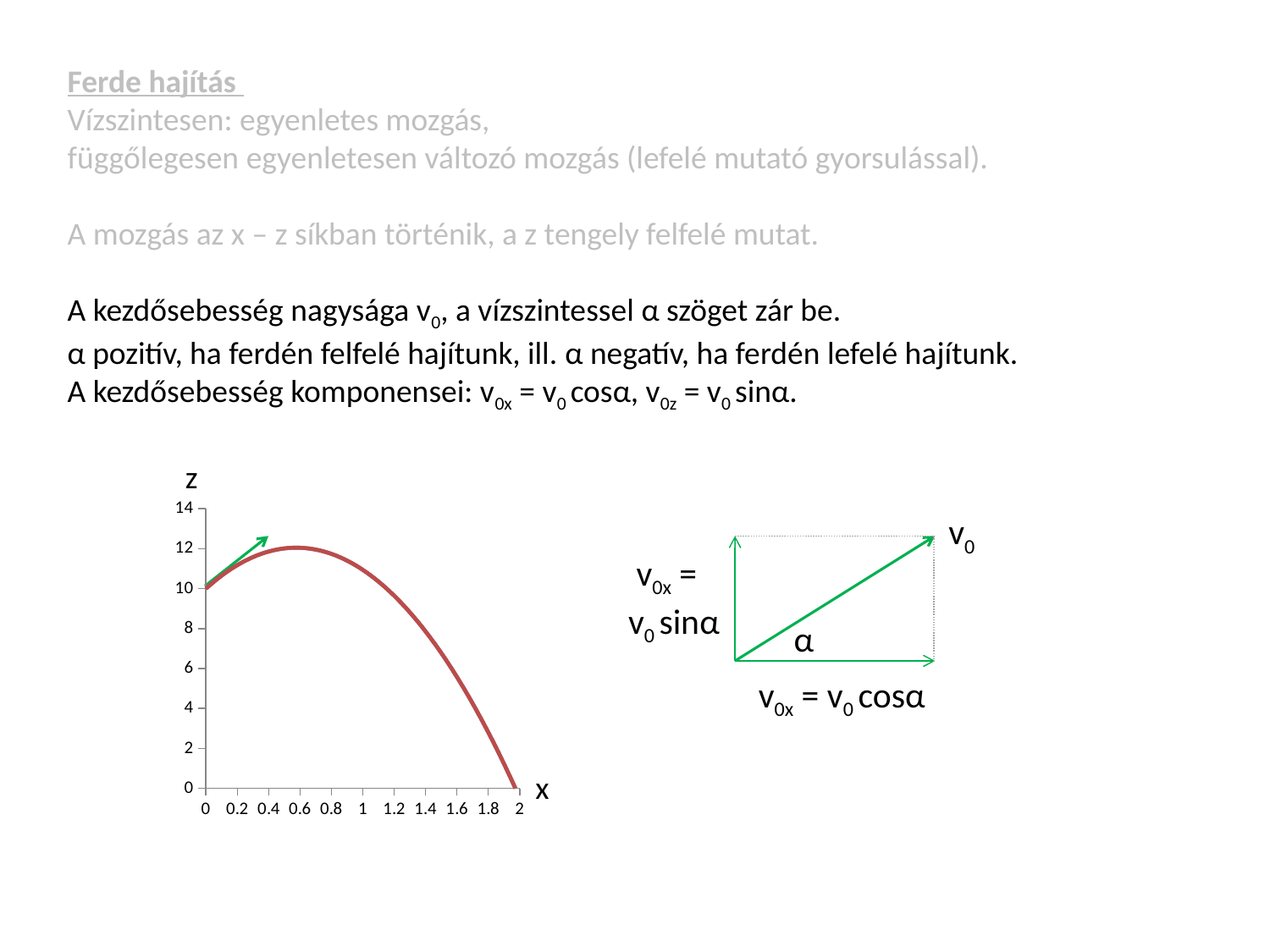
What kind of chart is shown on the slide? line chart What is the highest value shown on the vertical (z) axis? 14 Does the curve rise or fall as x increases from 1 to 2? fall Is the value of z at x = 1 greater or less than 10? greater Is the value of z at x = 1.8 greater or less than 6? less What is the label of the horizontal axis of the chart? x What is the label of the vertical axis of the chart? z Is the value of z at x = 1.6 greater or less than 8? less What is the value of z where the curve starts at x = 0? 10 Which has the larger z value on the curve: x = 0.6 or x = 1.8? x = 0.6 How many tick labels are shown on the horizontal (x) axis? 11